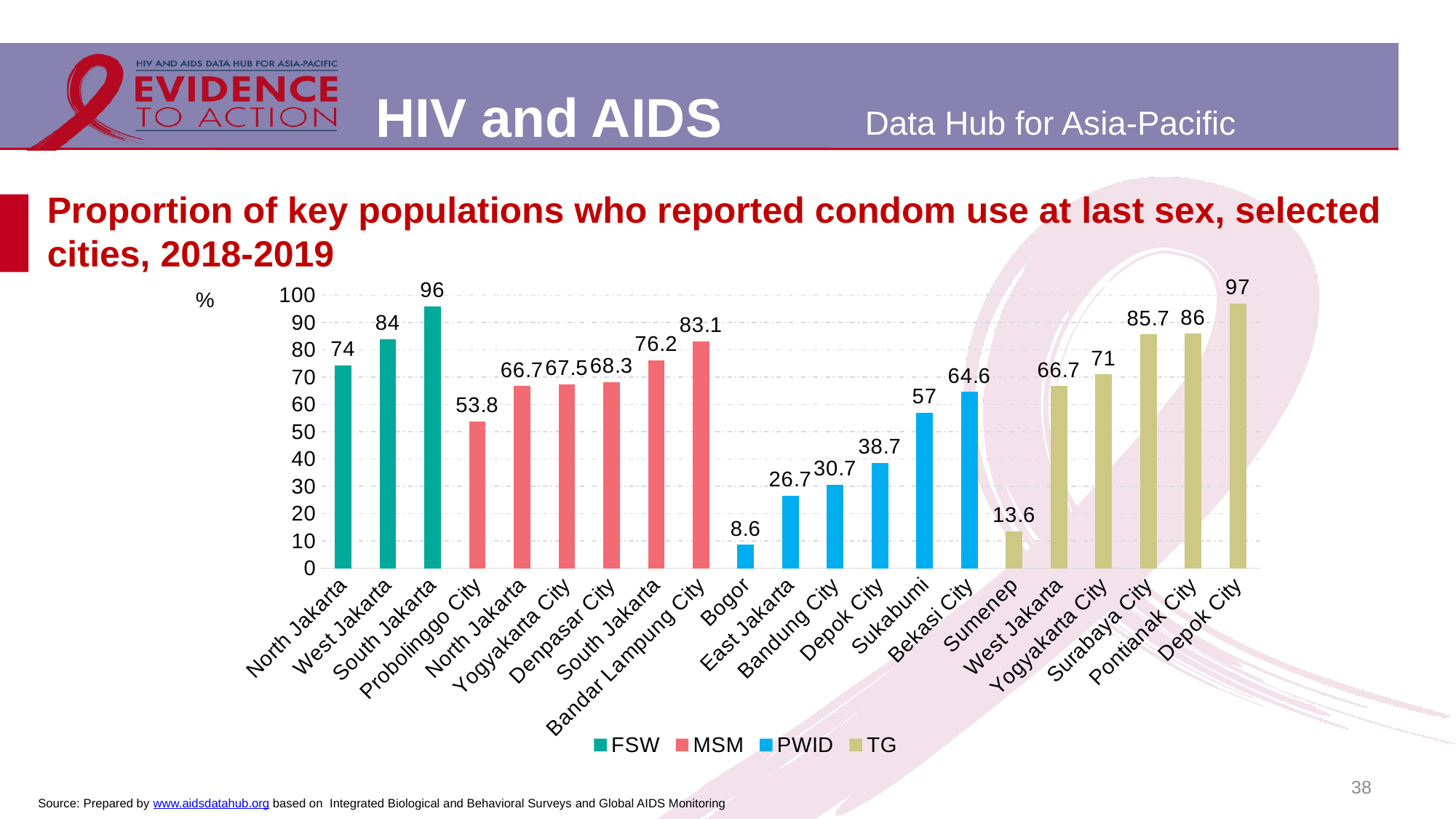
What is the value for Sumenep in the TG series? 13.6 Which is larger: the value for Depok City in the PWID series or the value for Depok City in the TG series? Depok City in the TG series Which city has the lowest value across the whole chart? Bogor How many bars are plotted in the chart? 21 What is the value for Bogor in the PWID series? 8.6 How many series does the legend list? 4 Which series is shown in blue in the legend? PWID What is the value for Bandar Lampung City in the MSM series? 83.1 What is the difference between the values for West Jakarta and North Jakarta in the FSW series? 10 What kind of chart is shown on the slide? Bar chart What is the value for South Jakarta in the FSW series? 96 Which city has the highest value in the TG series? Depok City